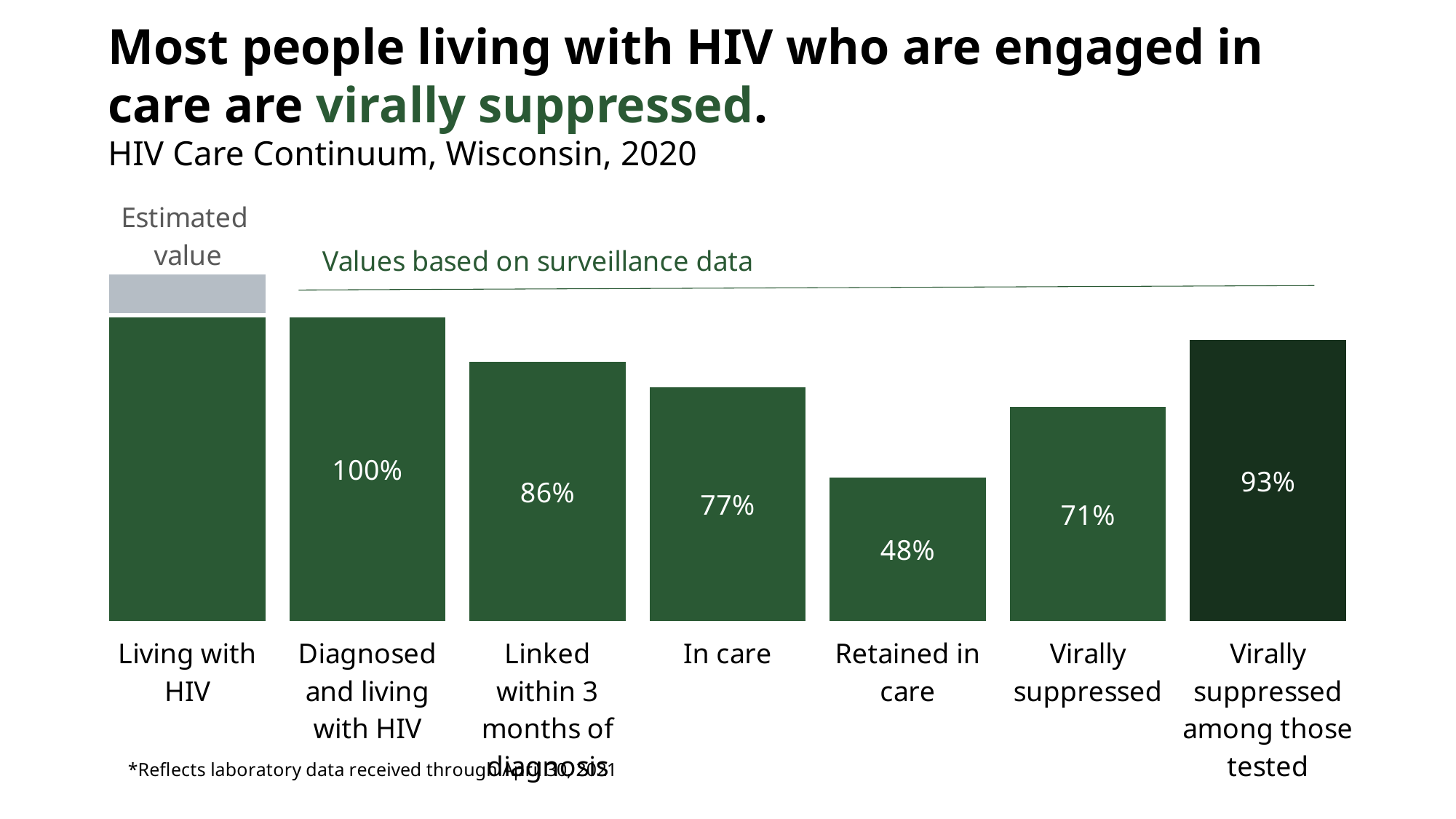
What is the value for Virally suppressed among those tested? 93% What is the value for Linked within 3 months of diagnosis? 86% Which labeled category has the lowest value? Retained in care What is the value for Diagnosed and living with HIV? 100% What is the difference between the values for In care and Virally suppressed? 6 percentage points What is the value for Retained in care? 48% What is the difference between Virally suppressed among those tested and Virally suppressed? 22 percentage points How many categories are shown on the x axis? 7 Which labeled category has the highest value? Diagnosed and living with HIV What kind of chart is shown on the slide? bar chart Which is larger, the value for In care or the value for Virally suppressed? In care Do the values rise or fall from Diagnosed and living with HIV to Retained in care? fall